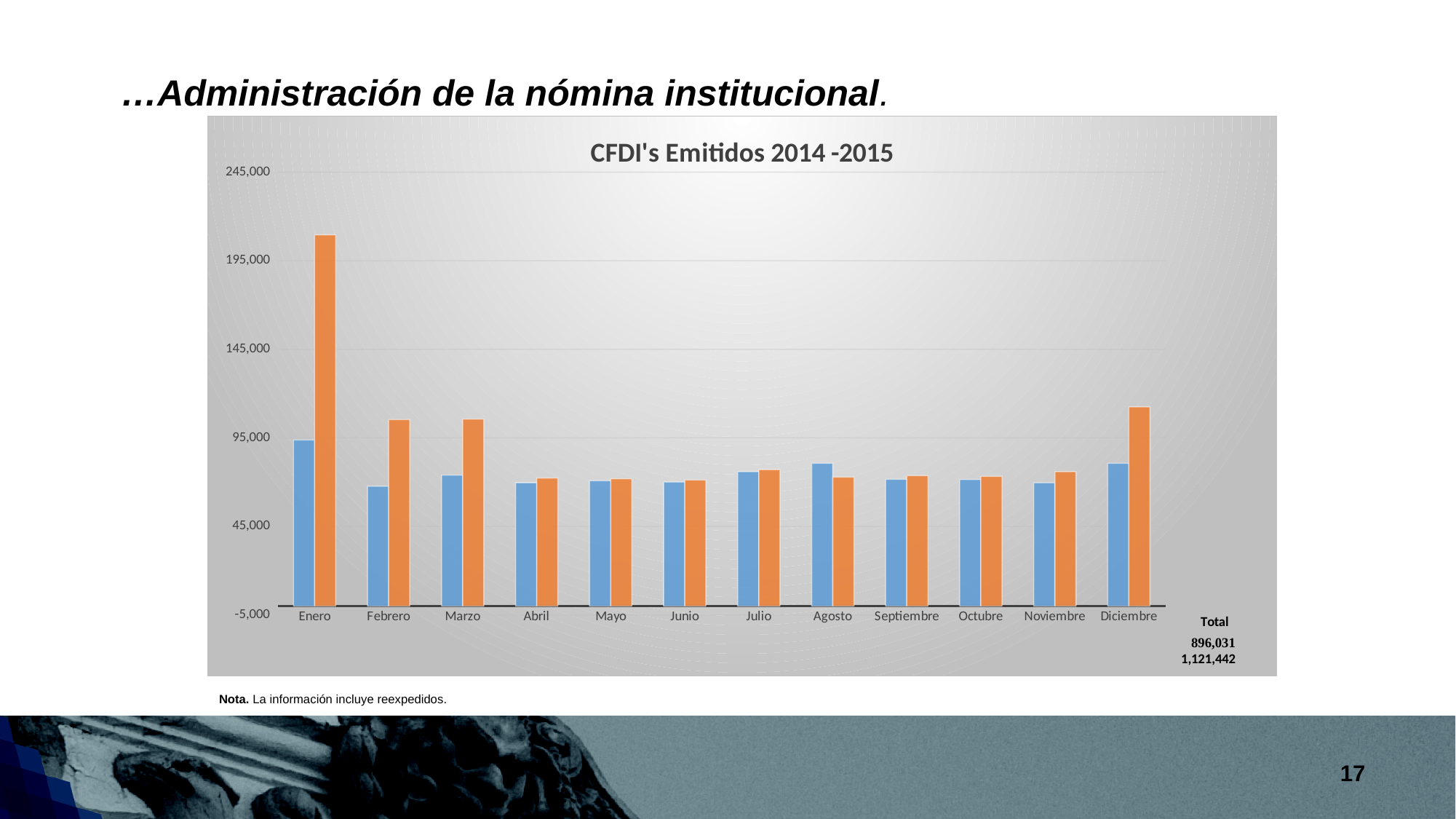
What is the title of the chart? CFDI's Emitidos 2014 -2015 How many months (categories) are shown on the x axis of the chart? 12 Do the orange bars rise or fall from Enero to Abril? Fall In Enero, which bar is larger, the blue bar or the orange bar? The orange bar Is the value of the blue bar for Abril greater or less than 95,000? less Is the value of the orange bar for Febrero greater or less than 95,000? greater Is the value of the orange bar for Enero greater or less than 195,000? greater Which month has the highest orange bar in the chart? Enero What type of chart is shown on the slide? Bar chart In Agosto, which bar is larger, the blue bar or the orange bar? The blue bar Which month has the highest blue bar in the chart? Enero